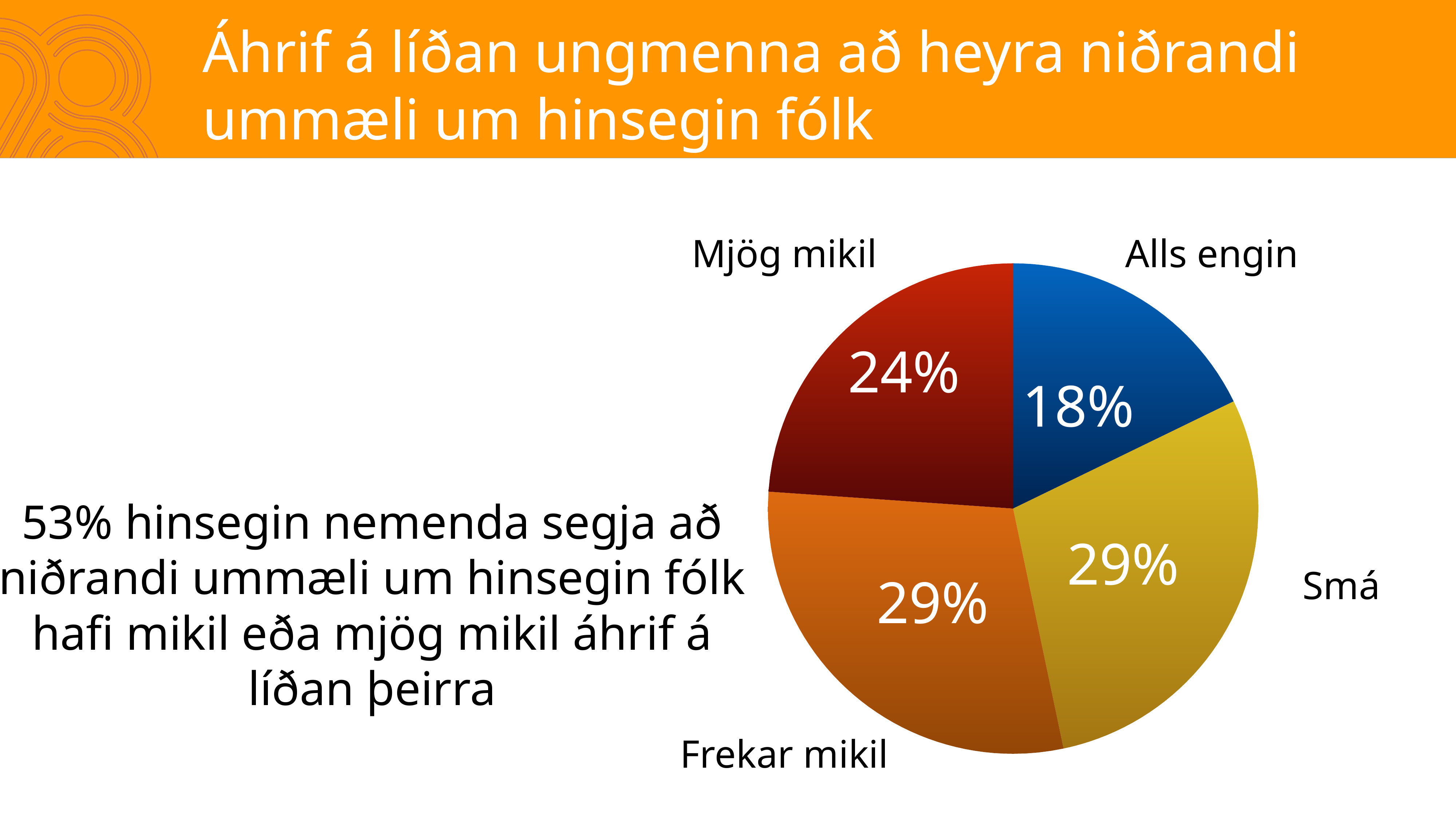
What is the value for "Frekar mikil"? 29% What is the value for "Mjög mikil"? 24% What is the difference between the values for "Smá" and "Alls engin"? 11% What is the difference between the values for "Frekar mikil" and "Mjög mikil"? 5% Which is larger, the slice for "Mjög mikil" or the slice for "Alls engin"? Mjög mikil What kind of chart is shown on the slide? pie chart How many slices does the pie chart have? 4 What is the combined share of "Frekar mikil" and "Mjög mikil"? 53% What is the value for "Smá"? 29% Which category has the smallest slice of the pie? Alls engin What colour is the slice for "Alls engin"? blue What is the value for "Alls engin"? 18%